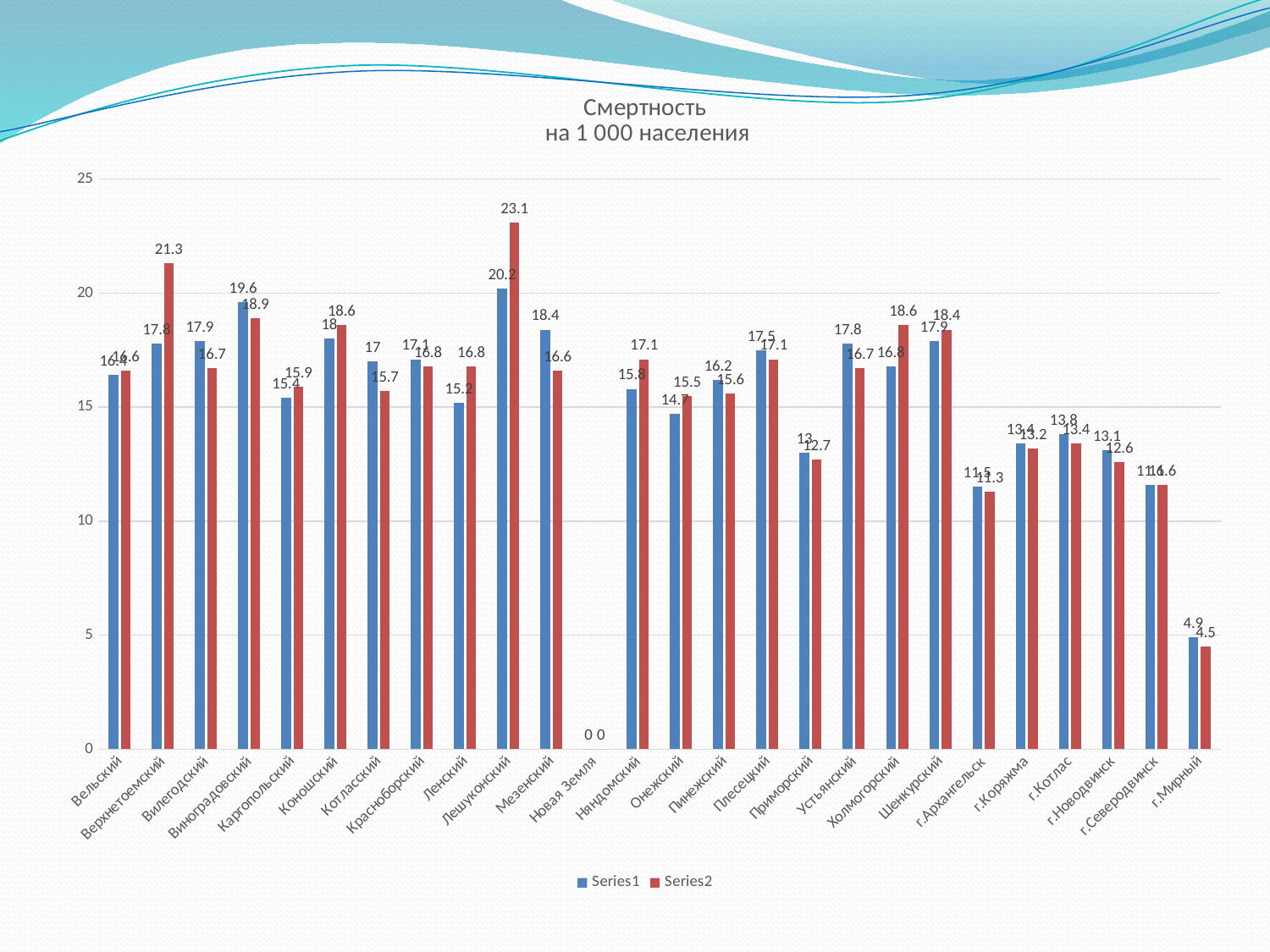
What is the title of the chart? Смертность на 1 000 населения Is the Series1 value for г.Архангельск greater or less than 15? less How many categories are shown on the x axis? 26 What is the Series2 value for г.Мирный? 4.5 What is the Series1 value for Верхнетоемский? 17.8 For Мезенский, which is larger, the Series1 value or the Series2 value? Series1 How many series does the legend list? 2 What is the Series2 value for Лешуконский? 23.1 Which category has the highest Series2 value? Лешуконский What type of chart is shown on the slide? bar chart Which category has the lowest Series1 value? Новая Земля What is the difference between the Series2 and Series1 values for Верхнетоемский? 3.5